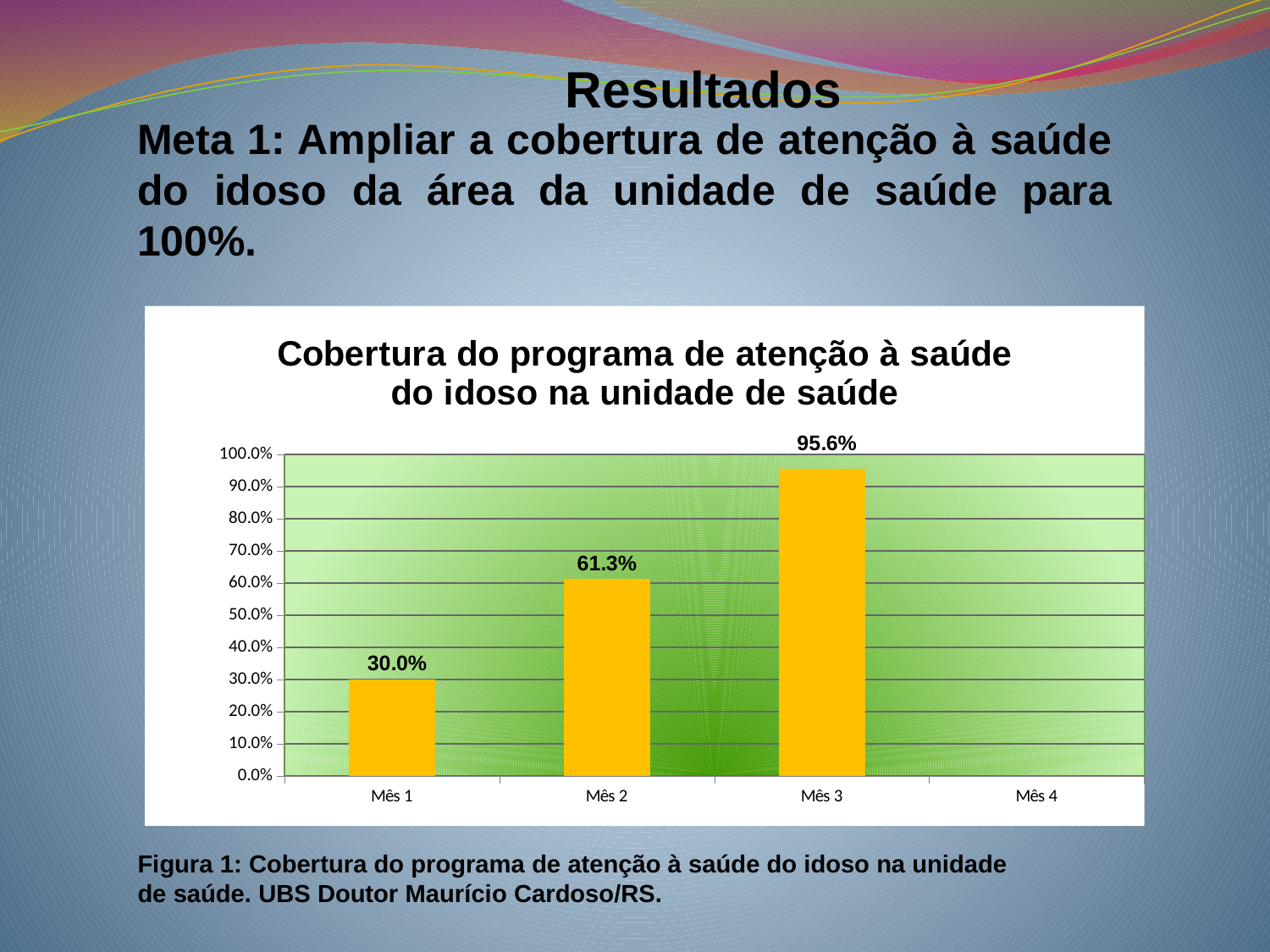
Do the values rise or fall from Mês 1 to Mês 3? Rise How many month categories are shown on the x axis? 4 Is the value for Mês 3 greater or less than 90.0%? greater What is the value for Mês 3? 95.6% Among the months with a plotted bar, which has the lowest value? Mês 1 Which month has the highest coverage value? Mês 3 What is the difference between the values for Mês 3 and Mês 2? 34.3% Which is larger, the value for Mês 1 or the value for Mês 2? Mês 2 What is the value for Mês 1? 30.0% What is the difference between the values for Mês 2 and Mês 1? 31.3% What is the value for Mês 2? 61.3% What kind of chart is shown on the slide? Bar chart